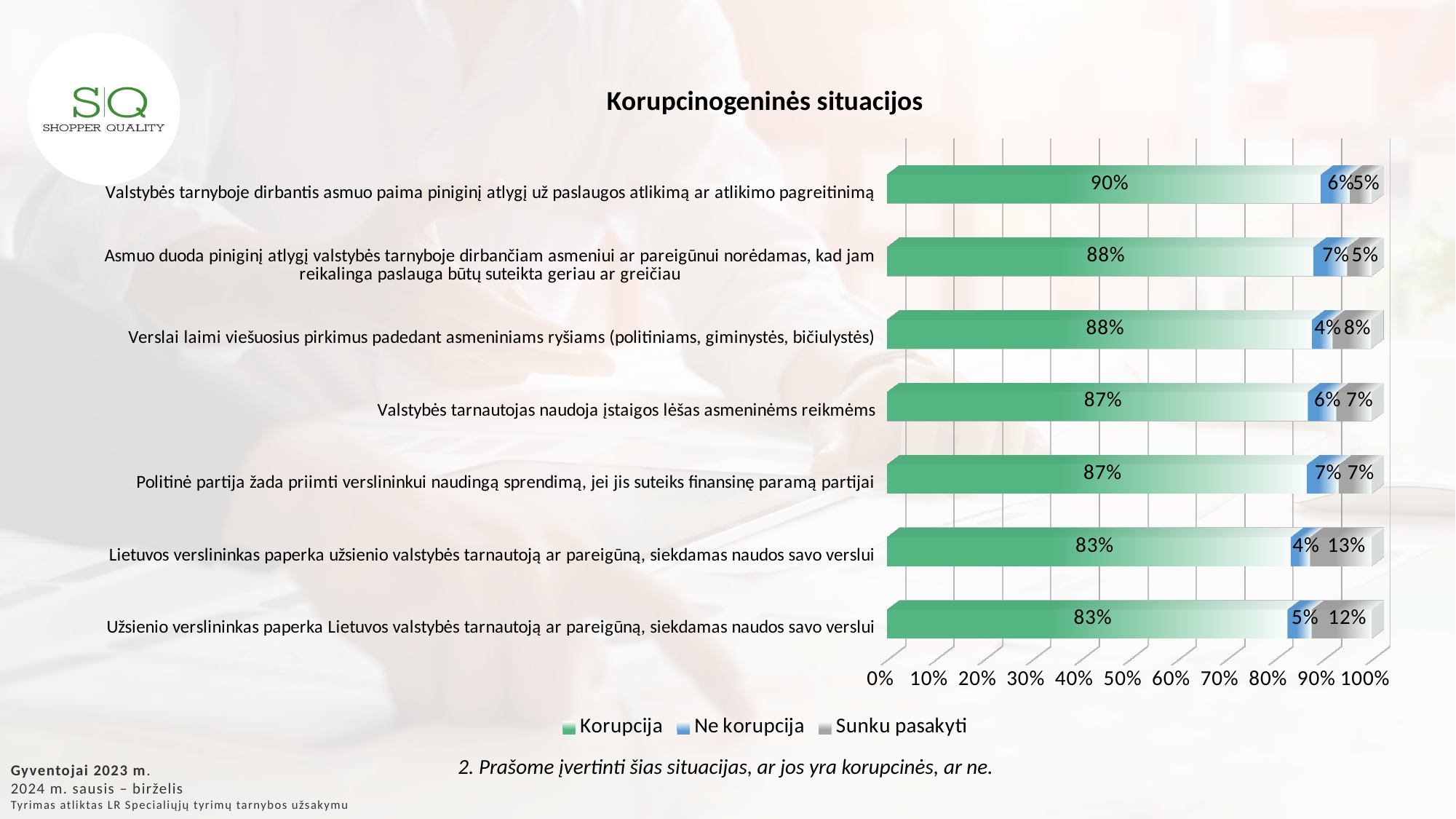
What colour represents the Korupcija series in the chart? Green What is the difference between the Korupcija value for 'Valstybės tarnyboje dirbantis asmuo paima piniginį atlygį už paslaugos atlikimą ar atlikimo pagreitinimą' and for 'Užsienio verslininkas paperka Lietuvos valstybės tarnautoją ar pareigūną, siekdamas naudos savo verslui'? 7% What is the Ne korupcija value for 'Verslai laimi viešuosius pirkimus padedant asmeniniams ryšiams (politiniams, giminystės, bičiulystės)'? 4% How many categories (situations) are plotted in the chart? 7 What is the title of the chart? Korupcinogeninės situacijos What is the Sunku pasakyti value for 'Lietuvos verslininkas paperka užsienio valstybės tarnautoją ar pareigūną, siekdamas naudos savo verslui'? 13% Which is larger: the Sunku pasakyti value for 'Verslai laimi viešuosius pirkimus padedant asmeniniams ryšiams (politiniams, giminystės, bičiulystės)' or for 'Užsienio verslininkas paperka Lietuvos valstybės tarnautoją ar pareigūną, siekdamas naudos savo verslui'? Užsienio verslininkas paperka Lietuvos valstybės tarnautoją ar pareigūną, siekdamas naudos savo verslui Which category has the highest Korupcija value? Valstybės tarnyboje dirbantis asmuo paima piniginį atlygį už paslaugos atlikimą ar atlikimo pagreitinimą How many series does the legend list? 3 What is the Korupcija value for 'Valstybės tarnyboje dirbantis asmuo paima piniginį atlygį už paslaugos atlikimą ar atlikimo pagreitinimą'? 90% Which category has the highest Sunku pasakyti value? Lietuvos verslininkas paperka užsienio valstybės tarnautoją ar pareigūną, siekdamas naudos savo verslui What kind of chart is shown on the slide? Stacked bar chart